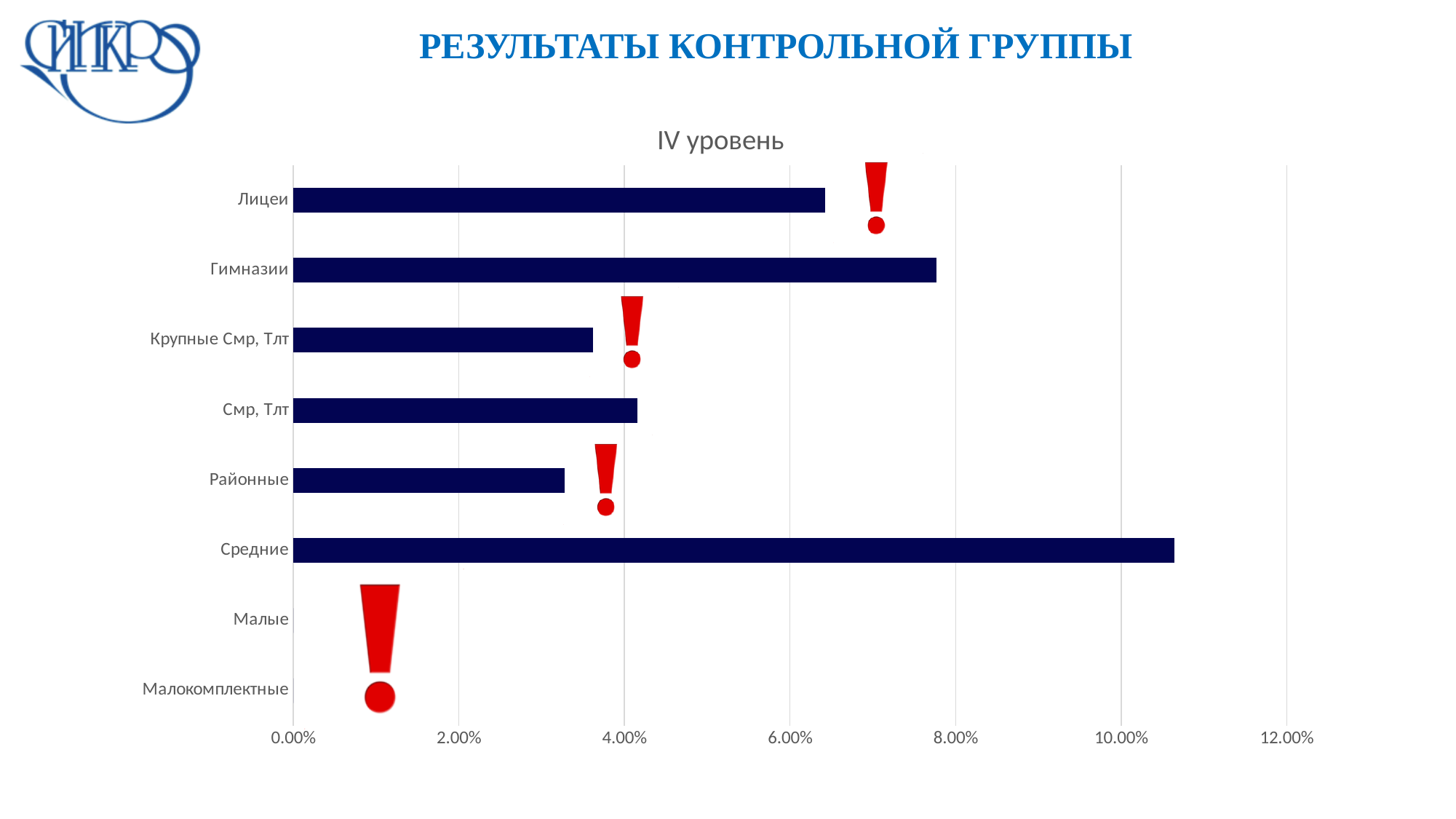
What is the maximum value shown on the horizontal axis of the chart? 12.00% Which category has the highest value in the chart? Средние Is the value for Районные greater or less than 4.00%? less Is the value for Лицеи greater or less than 6.00%? greater Which has a larger value, Смр, Тлт or Районные? Смр, Тлт Is the value for Гимназии greater or less than 8.00%? less How many categories are listed on the vertical axis of the chart? 8 What is the title of the chart? IV уровень Which has a larger value, Гимназии or Лицеи? Гимназии What type of chart is shown on the slide? Bar chart